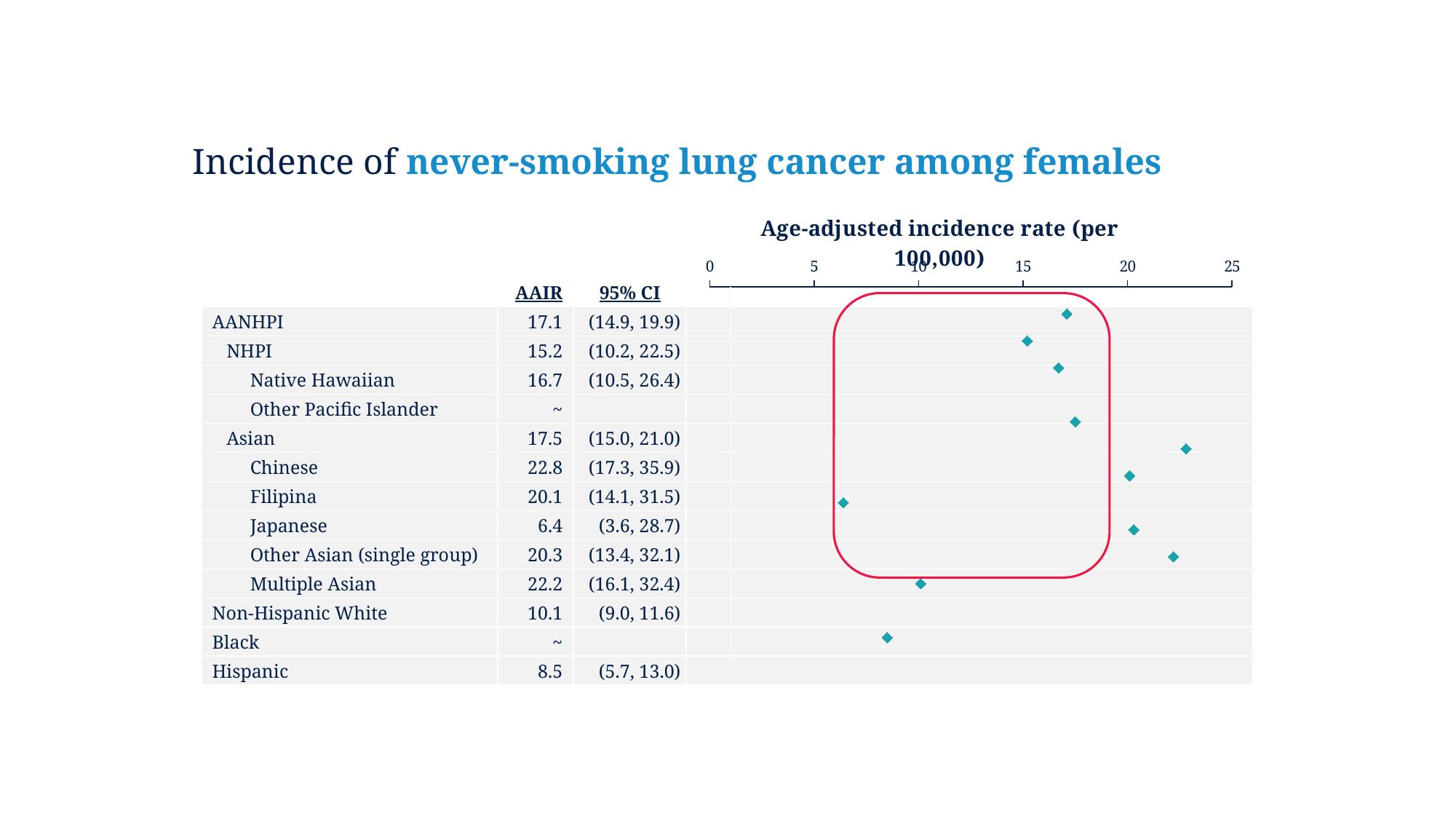
What is the title of the chart's horizontal axis? Age-adjusted incidence rate (per 100,000) What is the difference between the AAIR for AANHPI and the AAIR for Non-Hispanic White? 7.0 Is the AAIR for Hispanic females greater or less than 10? less Which has a higher AAIR, Other Asian (single group) or Filipina? Other Asian (single group) What is the AAIR for Chinese females? 22.8 What is the maximum value shown on the horizontal axis? 25 Which group has the lowest reported AAIR? Japanese Which group has the highest AAIR? Chinese What is the difference between the AAIR for Chinese and the AAIR for Japanese? 16.4 What is the AAIR for Non-Hispanic White females? 10.1 How many groups are listed in the table? 13 What is the 95% CI for Japanese females? (3.6, 28.7)